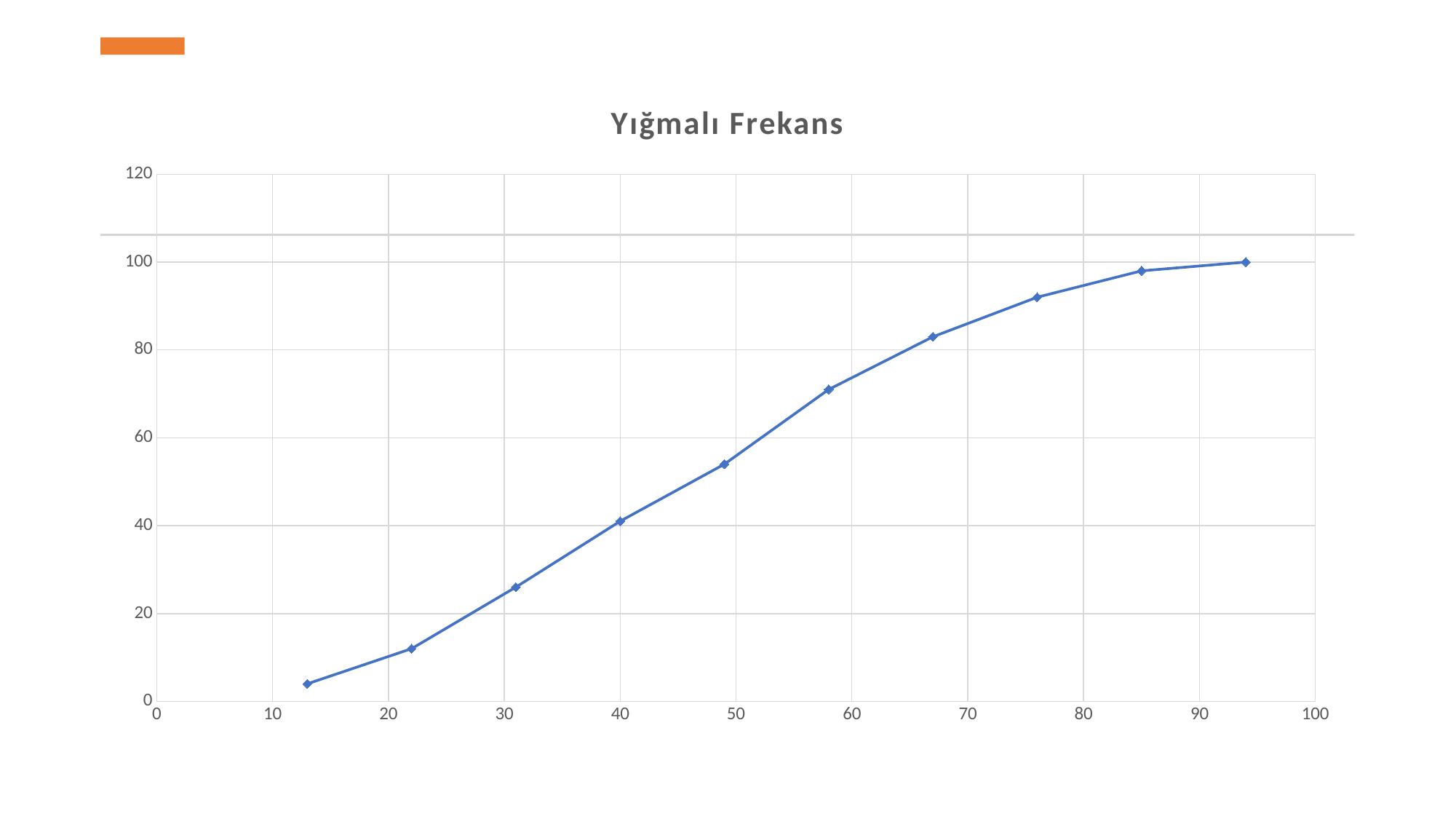
Is the value of the rightmost point greater or less than 120? less Do the plotted values rise or fall as you move from left to right along the x axis? rise What kind of chart is shown on the slide? line chart Which has the larger value, the leftmost point or the rightmost point? the rightmost point Is the value of the point nearest x = 60 greater or less than 60? greater Is the value of the point nearest x = 30 greater or less than 40? less What is the title of the chart? Yığmalı Frekans What is the highest value shown on the y axis? 120 How many data points are plotted on the line? 10